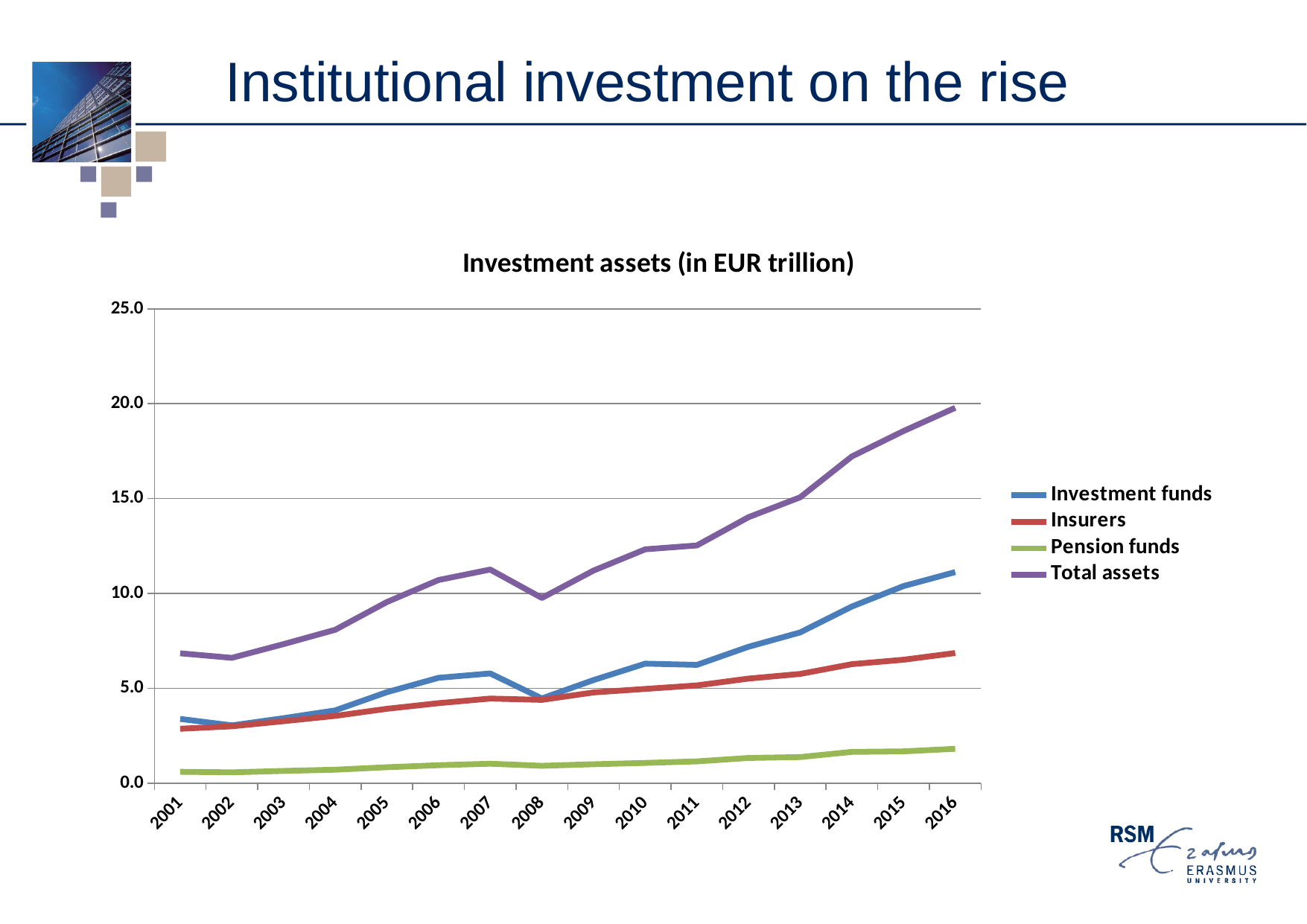
Between 2007 and 2008, did the value for Total assets rise or fall? fall Which series has the highest value in 2016? Total assets Is the value for Pension funds in 2016 greater or less than 5.0? less What kind of chart is shown on the slide? line chart How many years are shown on the x axis? 16 Is the value for Total assets in 2016 greater or less than 15.0? greater How many series does the legend list? 4 What is the title of the chart? Investment assets (in EUR trillion) Which series has the lowest value in 2016? Pension funds Is the value for Investment funds in 2016 greater or less than 10.0? greater In 2016, which is larger: Investment funds or Insurers? Investment funds